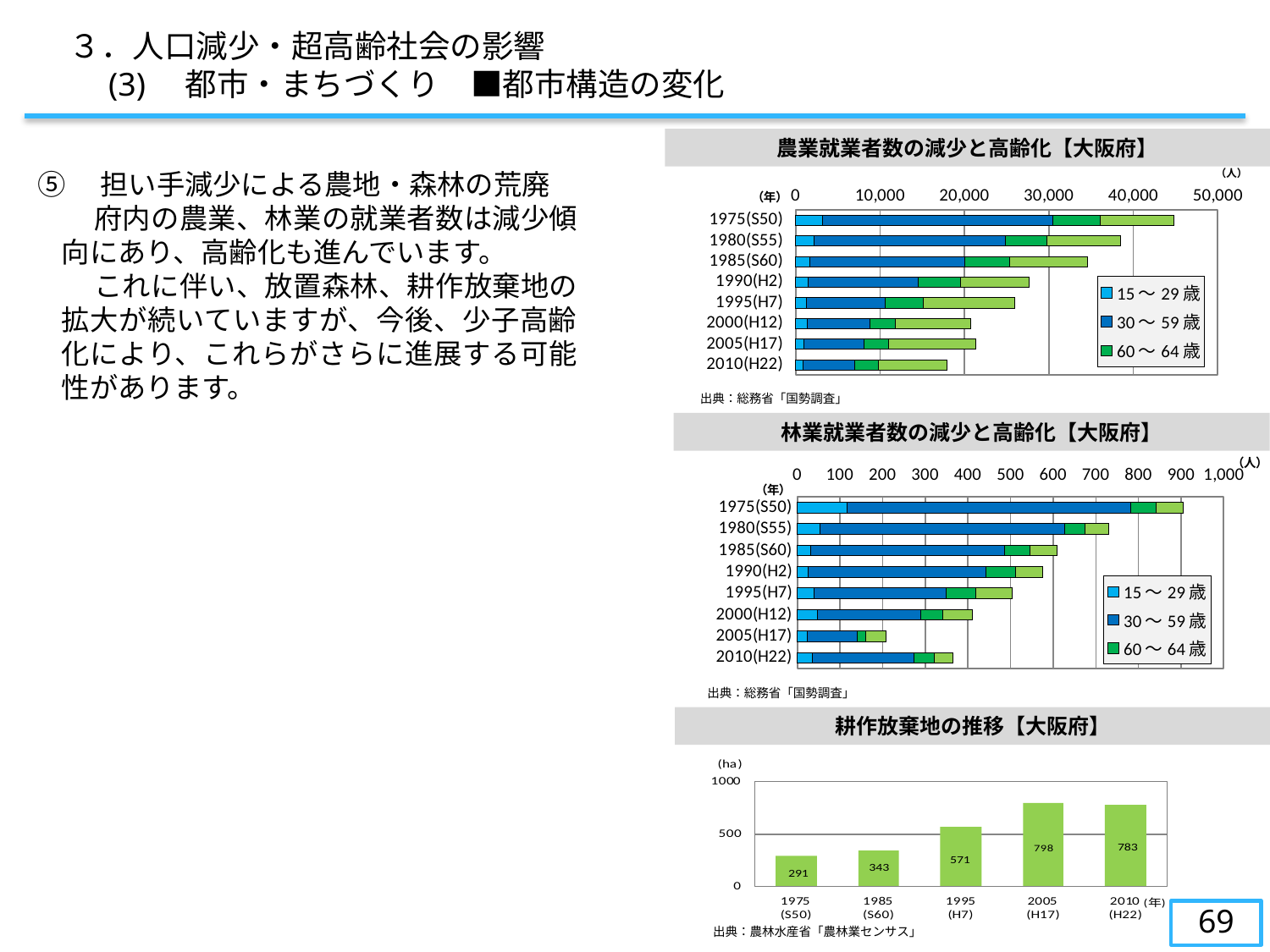
In the chart titled 耕作放棄地の推移【大阪府】, what is the value for 1975(S50)? 291 In the chart titled 農業就業者数の減少と高齢化【大阪府】, is the total for 1975(S50) greater or less than 40,000? greater In the chart titled 耕作放棄地の推移【大阪府】, which is larger, the value for 2005(H17) or 2010(H22)? 2005(H17) In the chart titled 林業就業者数の減少と高齢化【大阪府】, which year has the highest total? 1975(S50) In the chart titled 林業就業者数の減少と高齢化【大阪府】, is the total for 2000(H12) greater or less than 500? less In the chart titled 耕作放棄地の推移【大阪府】, which year has the lowest value? 1975(S50) In the chart titled 耕作放棄地の推移【大阪府】, what is the difference between the values for 2005(H17) and 1975(S50)? 507 In the chart titled 耕作放棄地の推移【大阪府】, what is the value for 2005(H17)? 798 In the chart titled 農業就業者数の減少と高齢化【大阪府】, how many series does the legend list? 3 In the chart titled 耕作放棄地の推移【大阪府】, how many years are shown? 5 In the chart titled 耕作放棄地の推移【大阪府】, which year has the highest value? 2005(H17) What kind of chart is the one titled 農業就業者数の減少と高齢化【大阪府】? Stacked bar chart